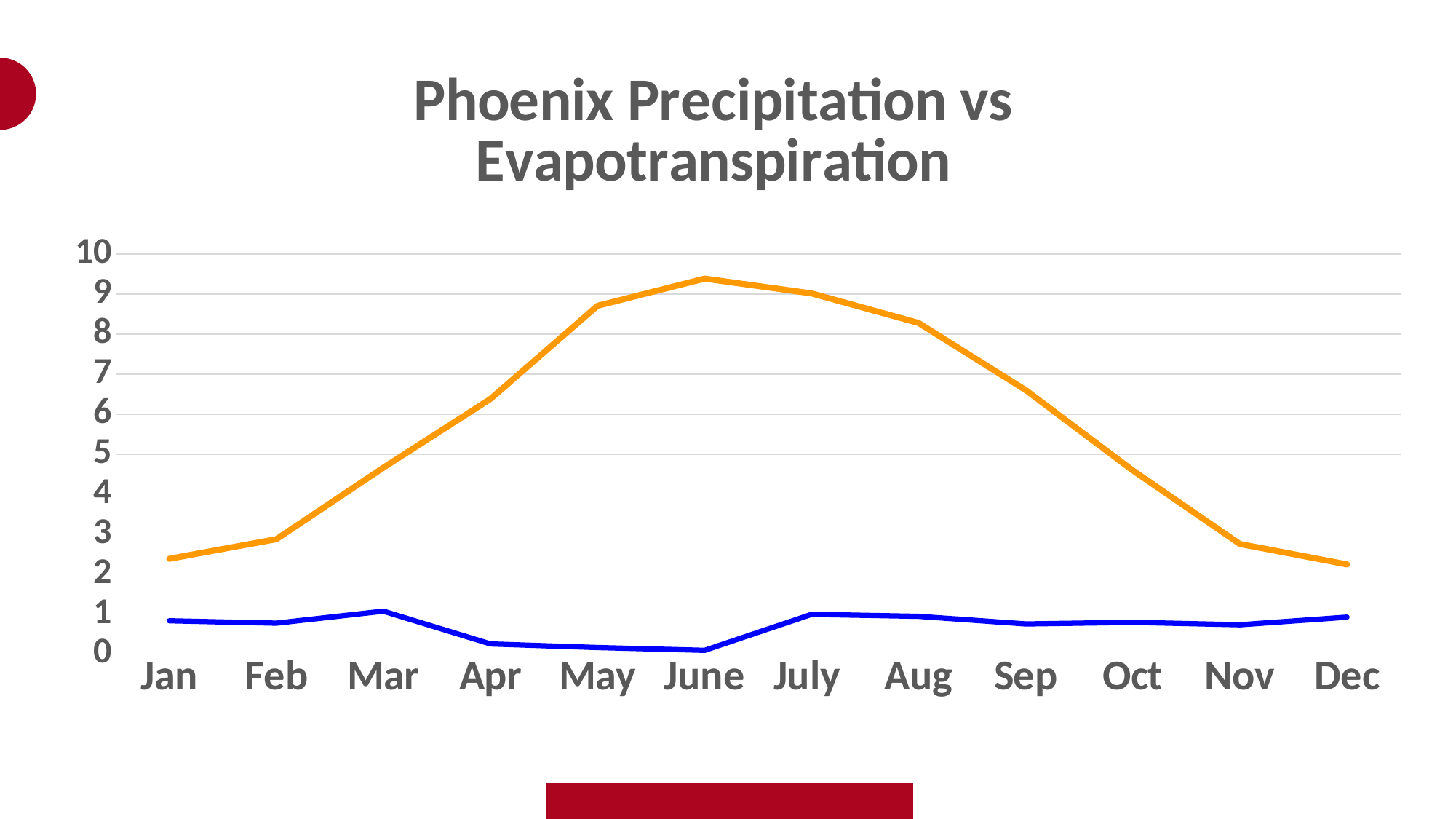
How many months are shown along the x axis? 12 Is the value of the orange line in Apr greater or less than 6? greater Is the value of the blue line in Mar greater or less than 2? less In which month does the orange line reach its highest value? June In June, which line has the larger value, the orange line or the blue line? orange line What is the title of the chart? Phoenix Precipitation vs Evapotranspiration What kind of chart is shown on the slide? line chart Is the value of the orange line in Jan greater or less than 3? less How many lines are plotted on the chart? 2 Does the orange line rise or fall from Jan to June? rise